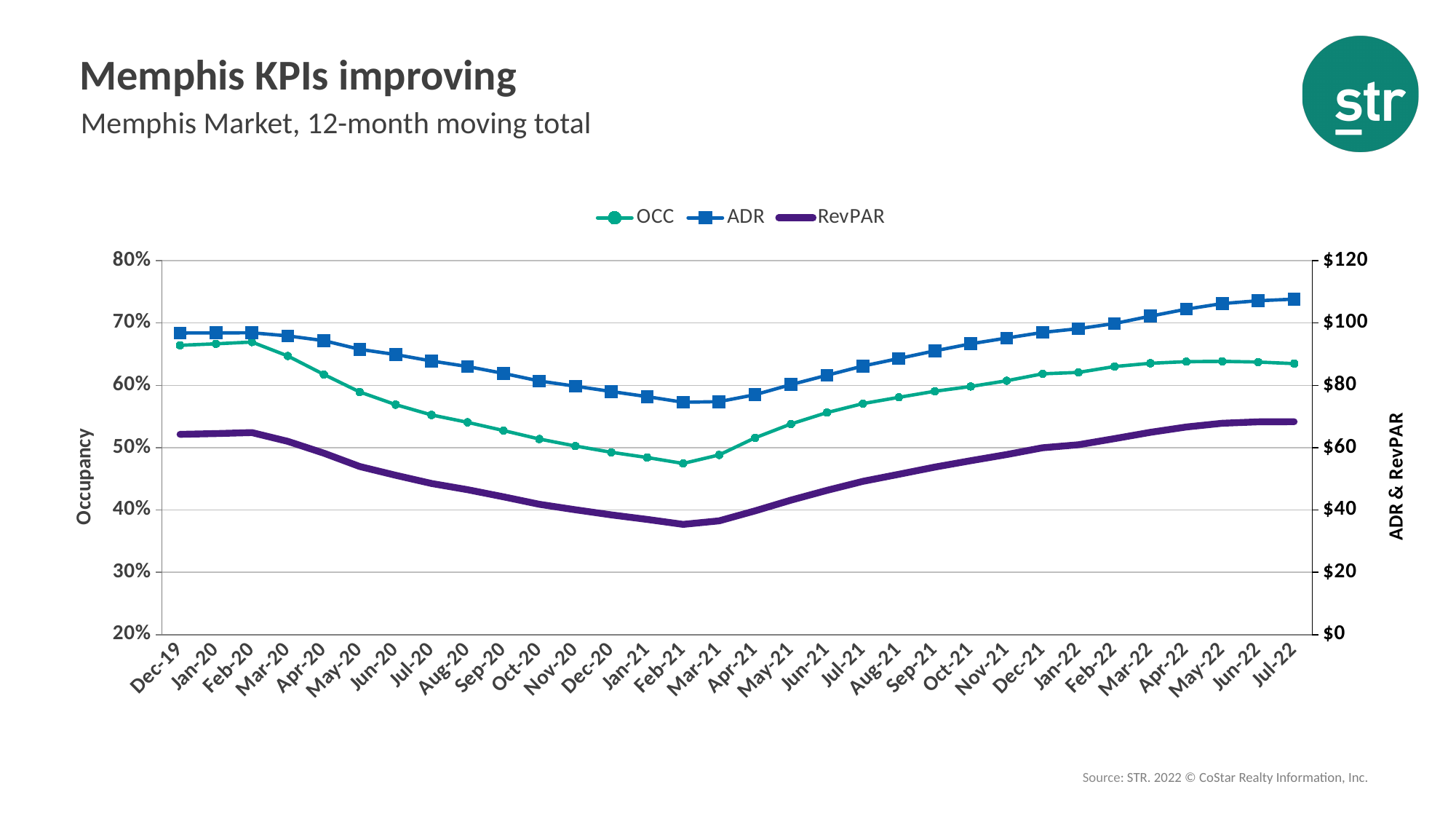
How many monthly points are plotted along the x axis? 32 How many series does the legend list? 3 Is the OCC value for Feb-21 greater or less than 50%? less Is the RevPAR value for Feb-21 greater or less than $40? less What kind of chart is shown on the slide? Line chart Is the OCC value for Dec-19 greater or less than 60%? greater Does the ADR series rise or fall from Dec-19 to Feb-21? Fall What is the label of the right-hand vertical axis? ADR & RevPAR Does the OCC series rise or fall from Feb-21 to Jul-22? Rise In which month is the OCC series at its lowest? Feb-21